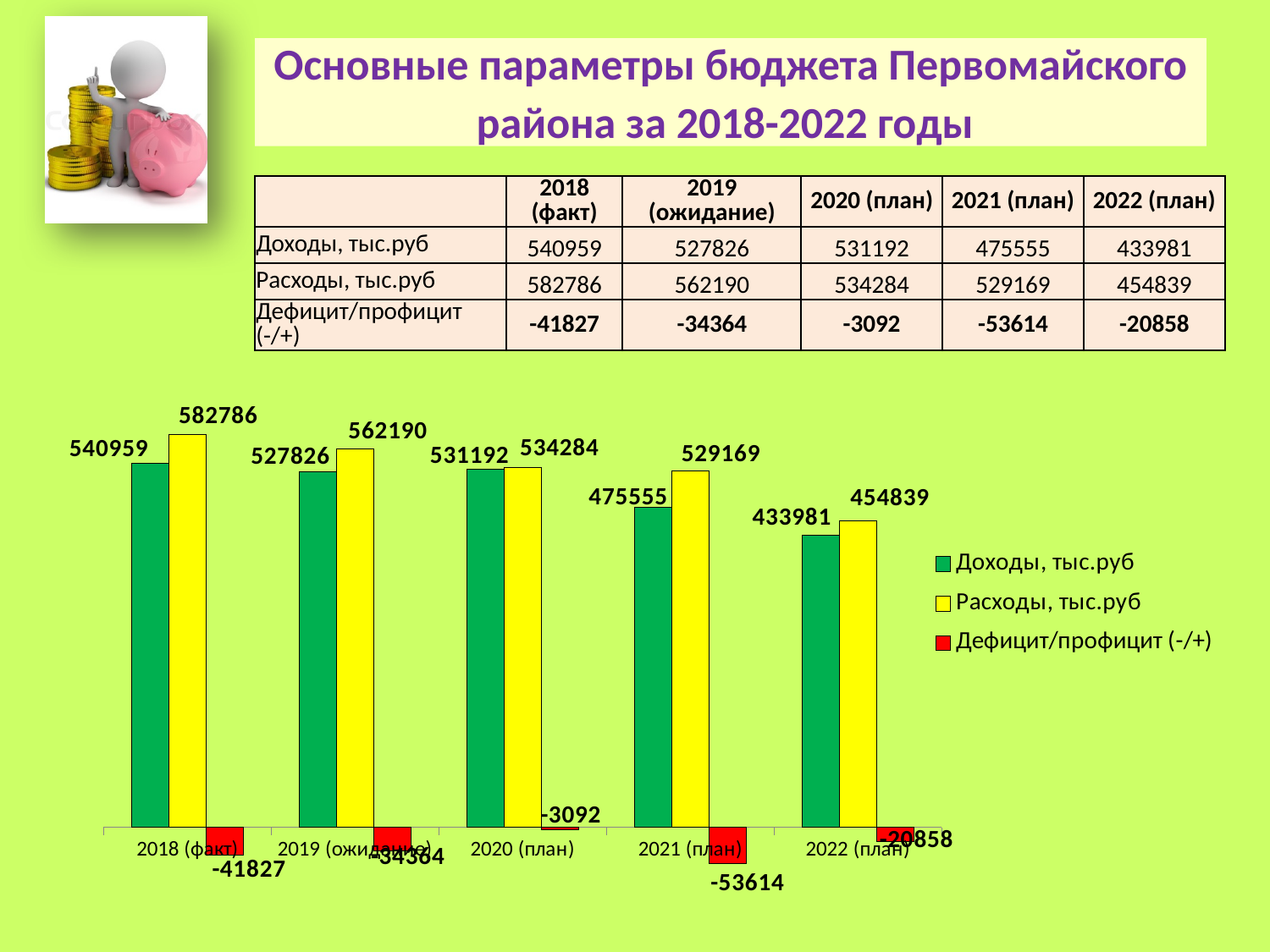
In which category is Доходы, тыс.руб lowest in the chart? 2022 (план) Do the Доходы, тыс.руб values generally rise or fall from 2018 (факт) to 2022 (план) in the chart? fall What colour are the Расходы, тыс.руб bars in the chart? yellow How many series does the chart legend list? 3 What kind of chart is shown on the slide? bar chart What is the value of Доходы, тыс.руб for 2018 (факт) in the chart? 540959 What is the difference between Расходы and Доходы for 2019 (ожидание) in the chart? 34364 Which is larger in the chart for 2022 (план): Доходы, тыс.руб or Расходы, тыс.руб? Расходы, тыс.руб How many categories (years) are shown on the x axis of the chart? 5 In which category is Расходы, тыс.руб highest in the chart? 2018 (факт) What is the value of Дефицит/профицит (-/+) for 2020 (план) in the chart? -3092 What is the value of Расходы, тыс.руб for 2021 (план) in the chart? 529169